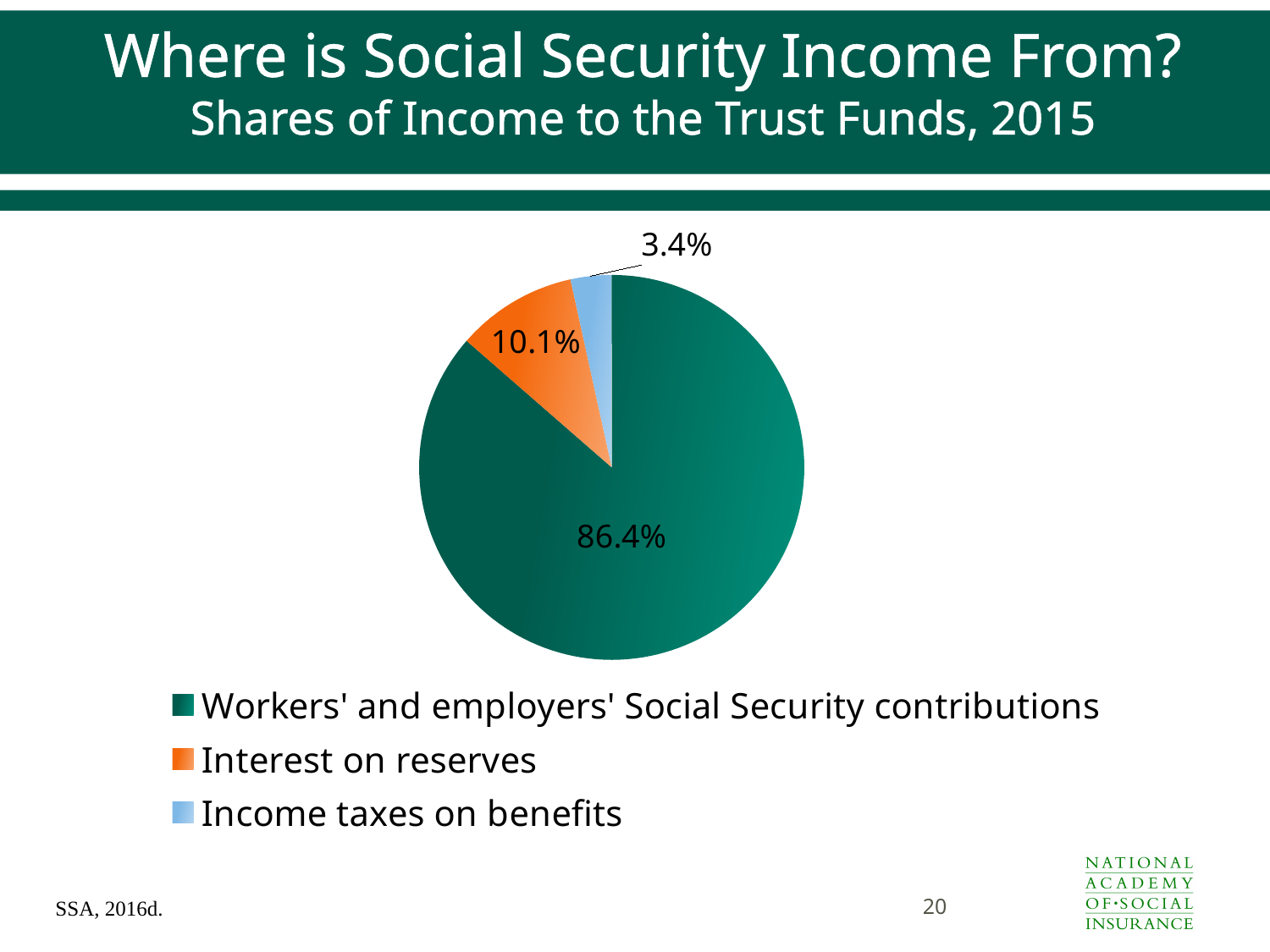
What kind of chart is shown on the slide? Pie chart How many percentage points larger is the share from interest on reserves than the share from income taxes on benefits? 6.7 percentage points Which is larger: the share from interest on reserves or the share from income taxes on benefits? Interest on reserves Which source accounts for the smallest share of income to the trust funds? Income taxes on benefits How many slices does the pie chart have? 3 What share of income to the trust funds comes from income taxes on benefits? 3.4% Which source accounts for the largest share of income to the trust funds? Workers' and employers' Social Security contributions What share of income to the trust funds comes from interest on reserves? 10.1% What share of income to the trust funds comes from workers' and employers' Social Security contributions? 86.4% How many percentage points larger is the share from workers' and employers' contributions than the share from interest on reserves? 76.3 percentage points What year does the chart's subtitle say the shares of income are for? 2015 What colour is the slice for interest on reserves? Orange